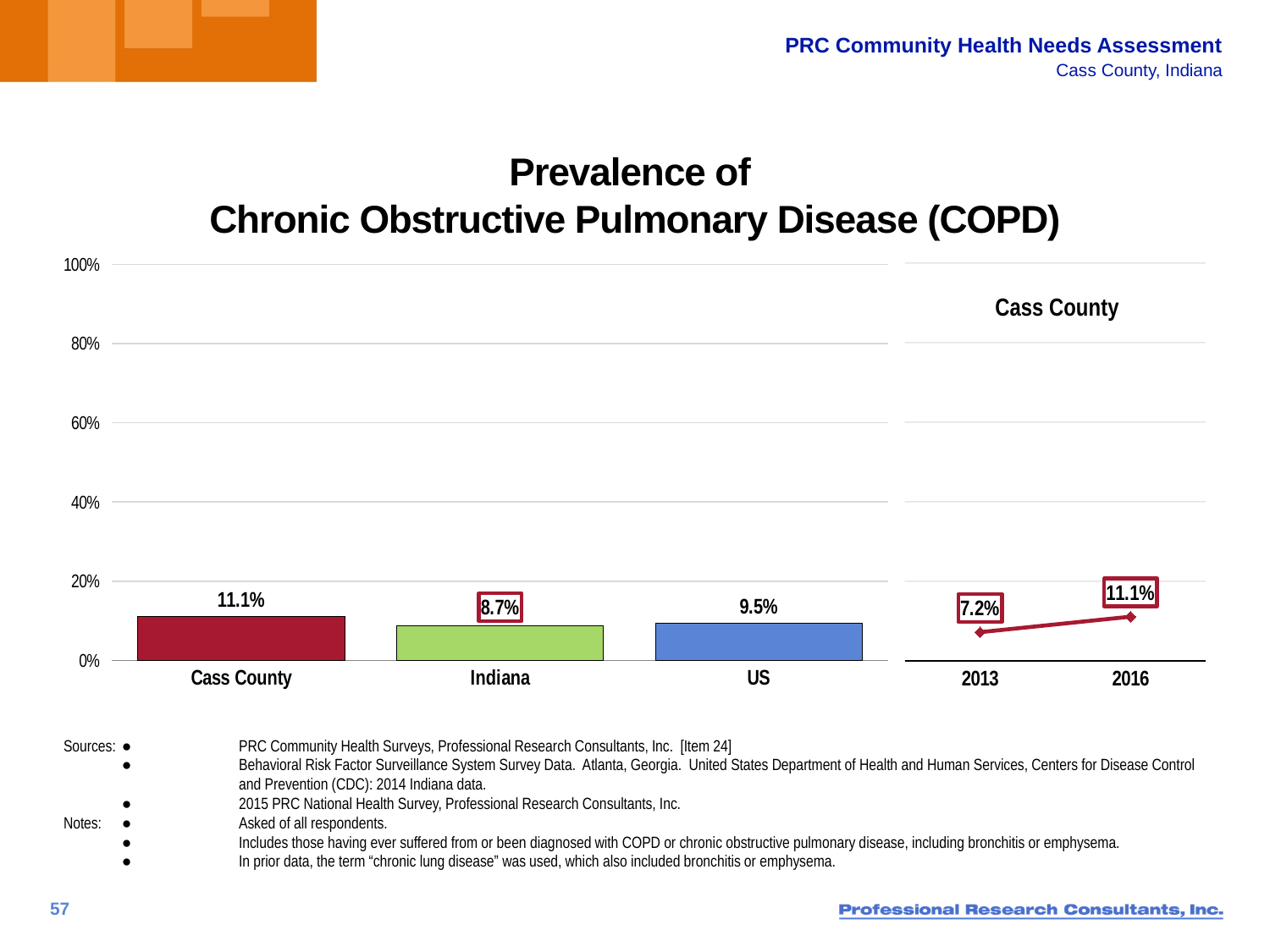
In the bar chart on the left, which category has the lowest COPD prevalence? Indiana In the bar chart on the left, what is the difference between the Cass County and Indiana values? 2.4% In the bar chart on the left, what is the COPD prevalence for the US? 9.5% In the bar chart on the left, which category has the highest COPD prevalence? Cass County In the Cass County trend chart on the right, what was the COPD prevalence in 2013? 7.2% In the Cass County trend chart on the right, what is the difference between the 2016 and 2013 values? 3.9% In the bar chart on the left, how many categories are shown? 3 In the Cass County trend chart on the right, did the value rise or fall from 2013 to 2016? Rise In the bar chart on the left, what is the COPD prevalence for Indiana? 8.7% What kind of chart is shown on the left side of the slide? Bar chart In the bar chart on the left, what is the COPD prevalence for Cass County? 11.1% In the bar chart on the left, which is larger, the US value or the Indiana value? US